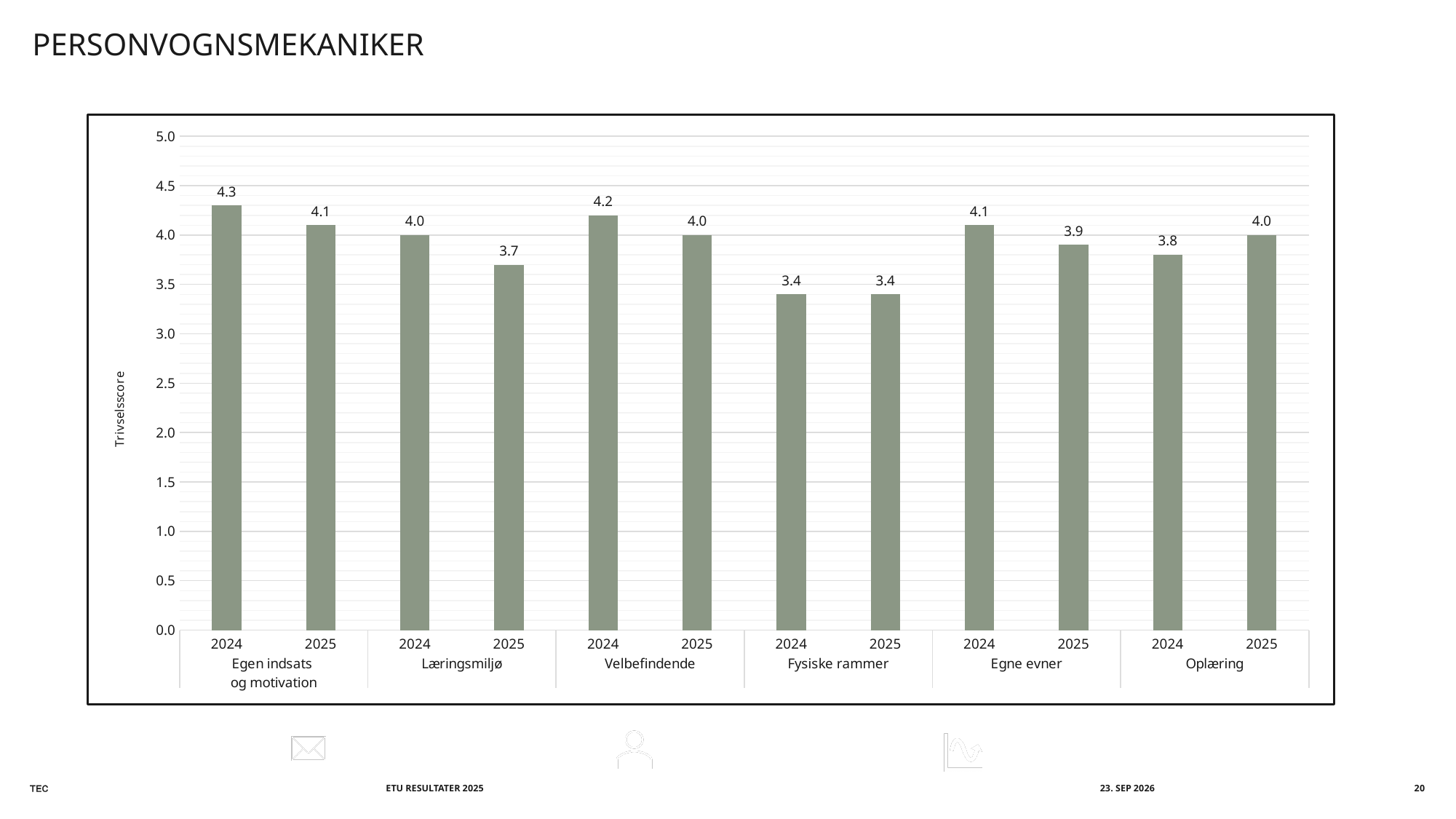
What is the difference between the 2024 and 2025 Trivselsscore for Læringsmiljø? 0.3 What is the Trivselsscore for Oplæring in 2024? 3.8 Which is larger, the 2024 or the 2025 Trivselsscore for Oplæring? 2025 How many categories are shown on the x axis of the chart? 6 Is the 2025 Trivselsscore for Egne evner greater or less than 3.5? greater What is the Trivselsscore for Fysiske rammer in 2025? 3.4 What is the label of the y axis? Trivselsscore Which bar has the highest Trivselsscore on the chart? Egen indsats og motivation 2024 Which category has the lowest Trivselsscore in 2024? Fysiske rammer What kind of chart is shown on the slide? Bar chart What is the Trivselsscore for Læringsmiljø in 2025? 3.7 What is the Trivselsscore for Egen indsats og motivation in 2024? 4.3